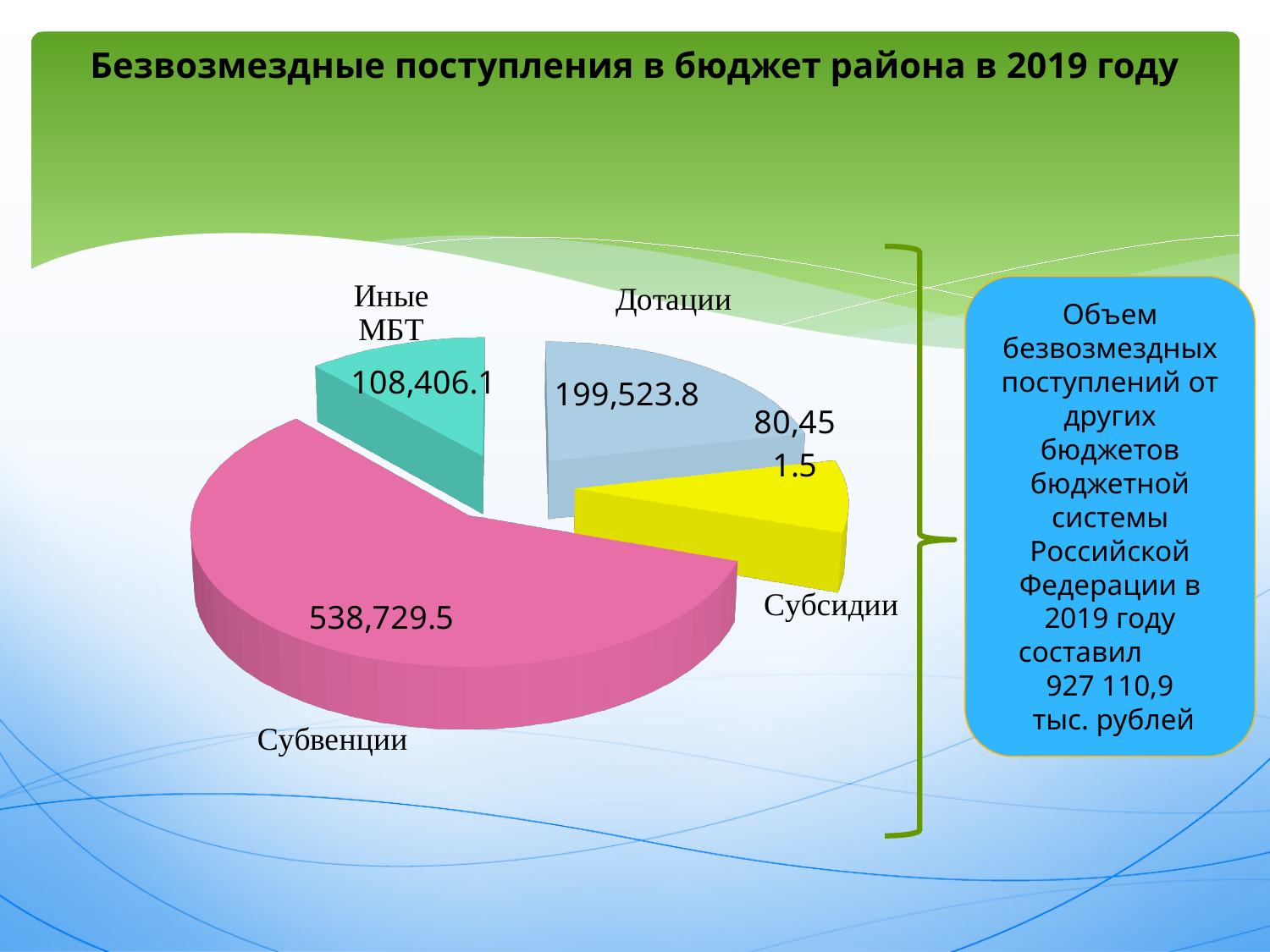
What is the difference between the values for Дотации and Иные МБТ? 91,117.7 Which category has the largest slice of the pie? Субвенции What is the title of the chart on the slide? Безвозмездные поступления в бюджет района в 2019 году What is the value for Дотации? 199,523.8 Which category has the smallest slice of the pie? Субсидии What is the difference between the values for Субвенции and Дотации? 339,205.7 How many slices does the pie chart have? 4 Which is larger, Дотации or Иные МБТ? Дотации What is the value for Субвенции? 538,729.5 What kind of chart is shown on the slide? Pie chart What colour is the Субвенции slice? Pink What is the value for Иные МБТ? 108,406.1